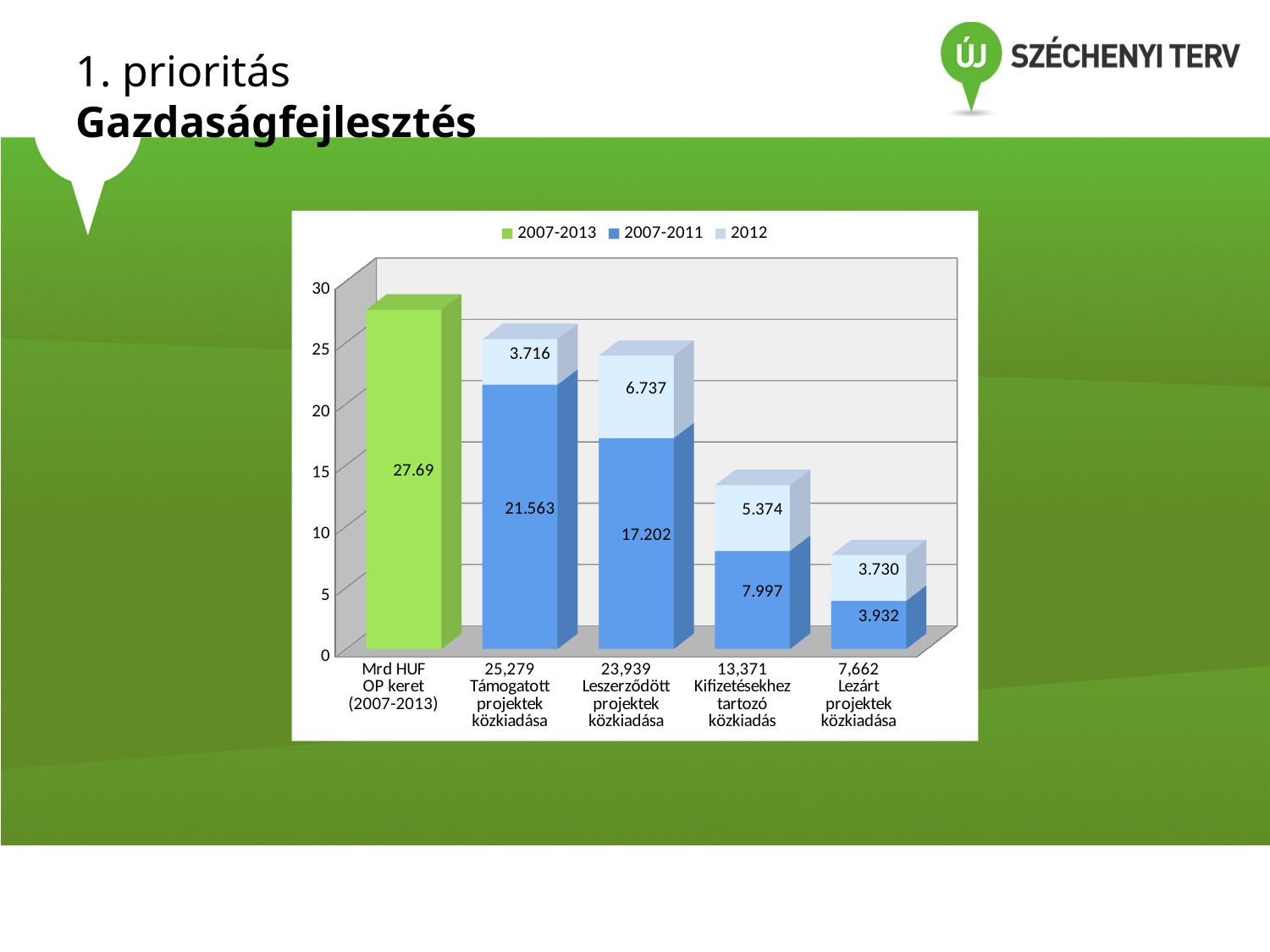
How many series does the legend list? 3 What kind of chart is shown on the slide? stacked bar chart What is the value of the 2007-2013 bar for 'Mrd HUF OP keret (2007-2013)'? 27.69 Which category has the highest 2012 value? Leszerződött projektek közkiadása Which is larger: the 2012 value for 'Kifizetésekhez tartozó közkiadás' or the 2012 value for 'Támogatott projektek közkiadása'? Kifizetésekhez tartozó közkiadás What is the 2012 value for 'Leszerződött projektek közkiadása'? 6.737 How many categories are shown on the x axis? 5 What is the difference between the 2007-2011 values for 'Támogatott projektek közkiadása' and 'Leszerződött projektek közkiadása'? 4.361 What is the 2007-2011 value for 'Kifizetésekhez tartozó közkiadás'? 7.997 Which category has the lowest 2007-2011 value? Lezárt projektek közkiadása What is the 2007-2011 value for 'Támogatott projektek közkiadása'? 21.563 What is the 2012 value for 'Lezárt projektek közkiadása'? 3.730